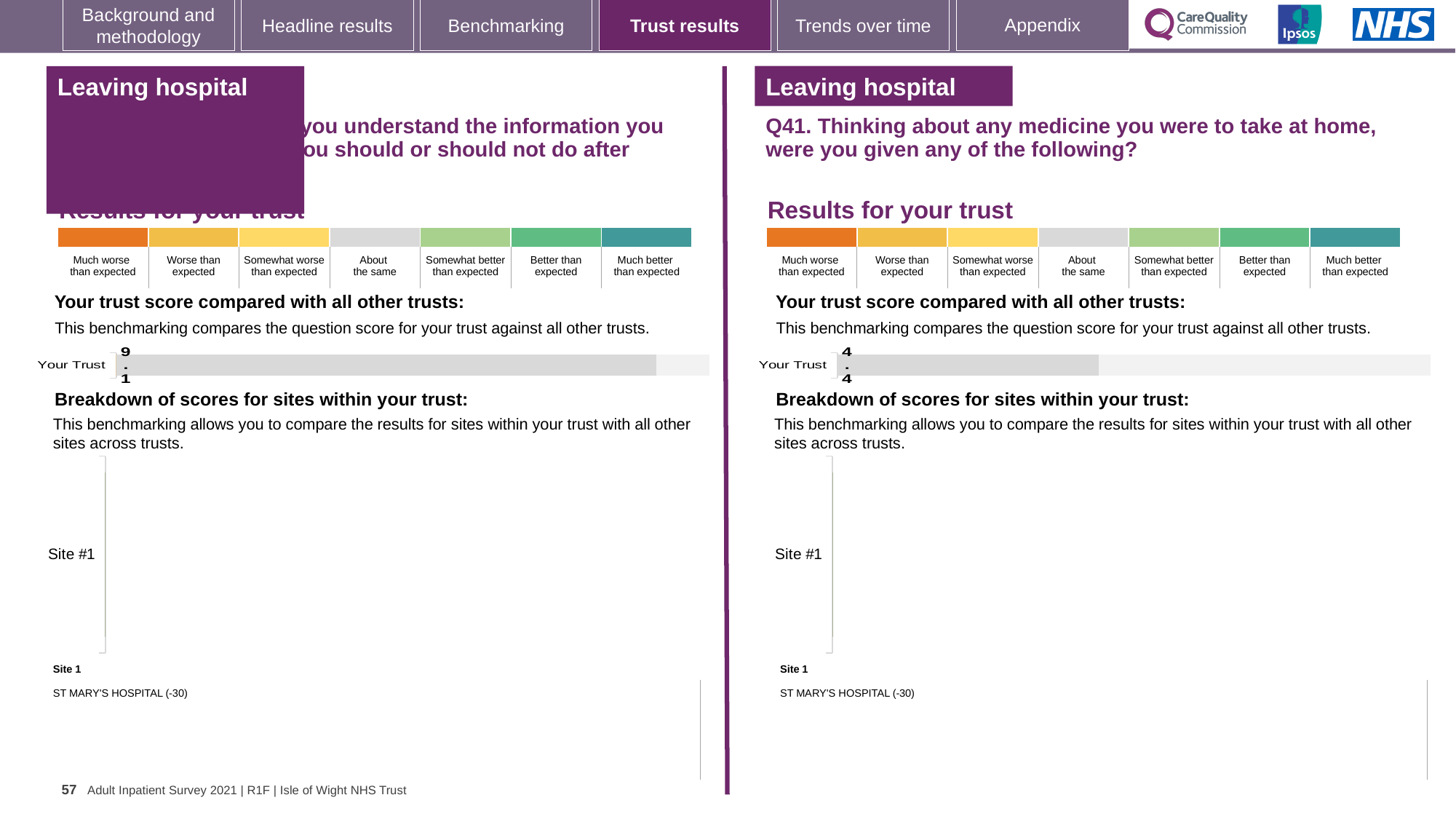
On the left panel, how many benchmark categories are shown in the colour scale from 'Much worse than expected' to 'Much better than expected'? 7 On the left chart, what is the score shown for Your Trust? 9.1 What is the difference between the Your Trust score on the left chart (9.1) and on the right chart (4.4)? 4.7 Which chart shows the higher Your Trust score, the left chart or the right chart (Q41)? The left chart What kind of chart is used to show the Your Trust score on the left panel? Bar chart On the right chart (Q41), what is the score shown for Your Trust? 4.4 On the right panel (Q41), which site is listed as Site 1 in the breakdown of scores? ST MARY'S HOSPITAL (-30) On the right chart (Q41), is the Your Trust score greater or less than 5? less On the right chart (Q41), how many categories are plotted in the Your Trust score chart? 1 On the left chart, is the Your Trust score greater or less than 5? greater